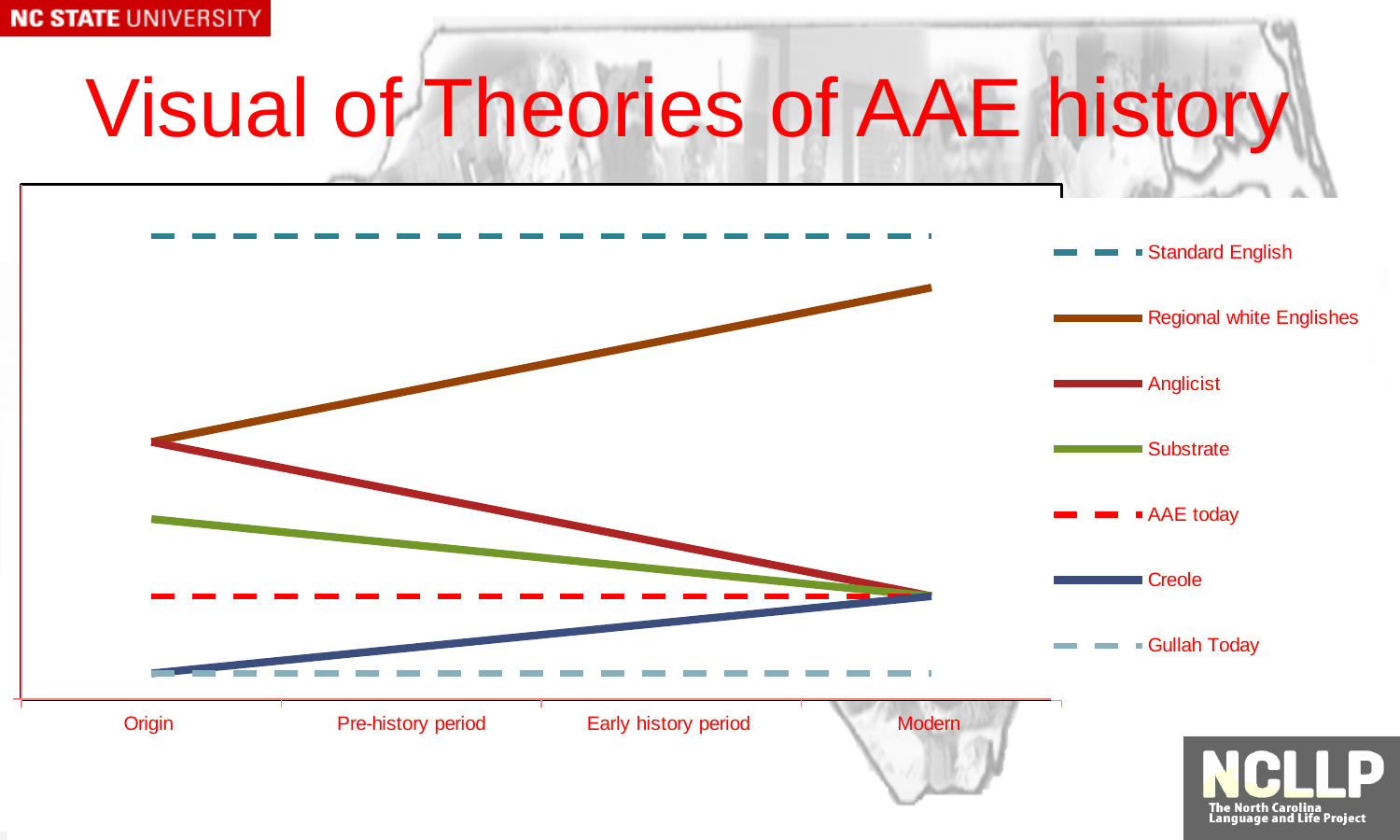
Which series is the lowest line at the Modern point of the chart? Gullah Today Which series is drawn as a red dashed line in the chart? AAE today What is the title of the slide containing the chart? Visual of Theories of AAE history Does the Creole line rise or fall from Origin to Modern? rise What kind of chart is shown on the slide? line chart How many series does the chart's legend list? 7 Which series is the highest line at the Modern point of the chart? Standard English Does the Substrate line rise or fall from Origin to Modern? fall Does the Anglicist line rise or fall from Origin to Modern? fall At the Origin point, which line is higher: Substrate or Creole? Substrate How many categories are shown along the x axis of the chart? 4